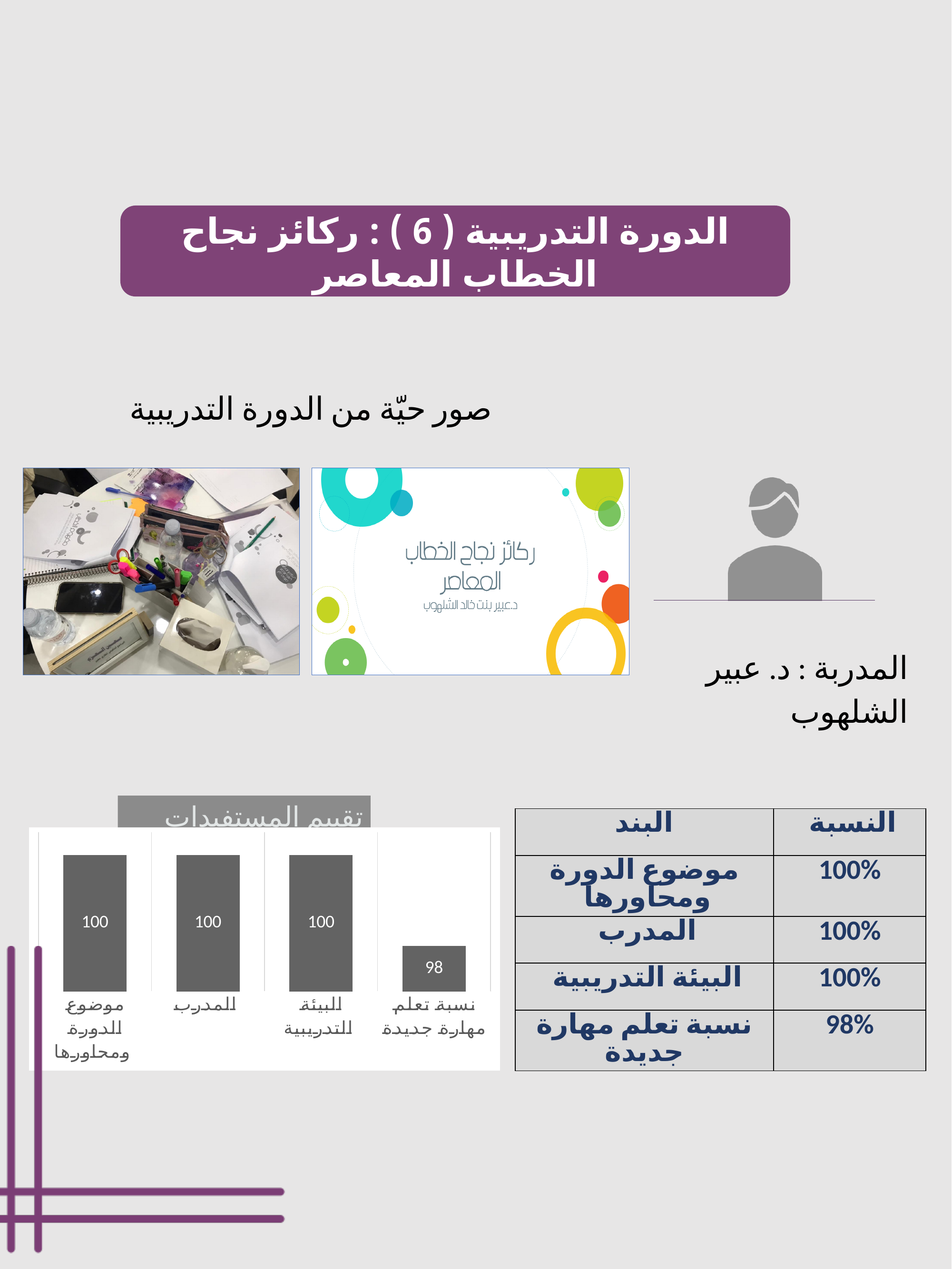
In the bar chart, what is the value for نسبة تعلم مهارة جديدة? 98 In the bar chart, which category has the lowest value? نسبة تعلم مهارة جديدة In the bar chart, what is the value for المدرب? 100 In the bar chart, what is the difference between the value for المدرب and the value for نسبة تعلم مهارة جديدة? 2 In the bar chart, is the value for نسبة تعلم مهارة جديدة greater or less than 100? less In the bar chart, what is the value for موضوع الدورة ومحاورها? 100 How many categories are shown in the bar chart? 4 In the bar chart, how many categories have a value of 100? 3 In the bar chart, what is the value for البيئة التدريبية? 100 What kind of chart is shown on the slide? bar chart In the bar chart, which is larger: the value for البيئة التدريبية or the value for نسبة تعلم مهارة جديدة? البيئة التدريبية What colour are the bars in the bar chart? grey